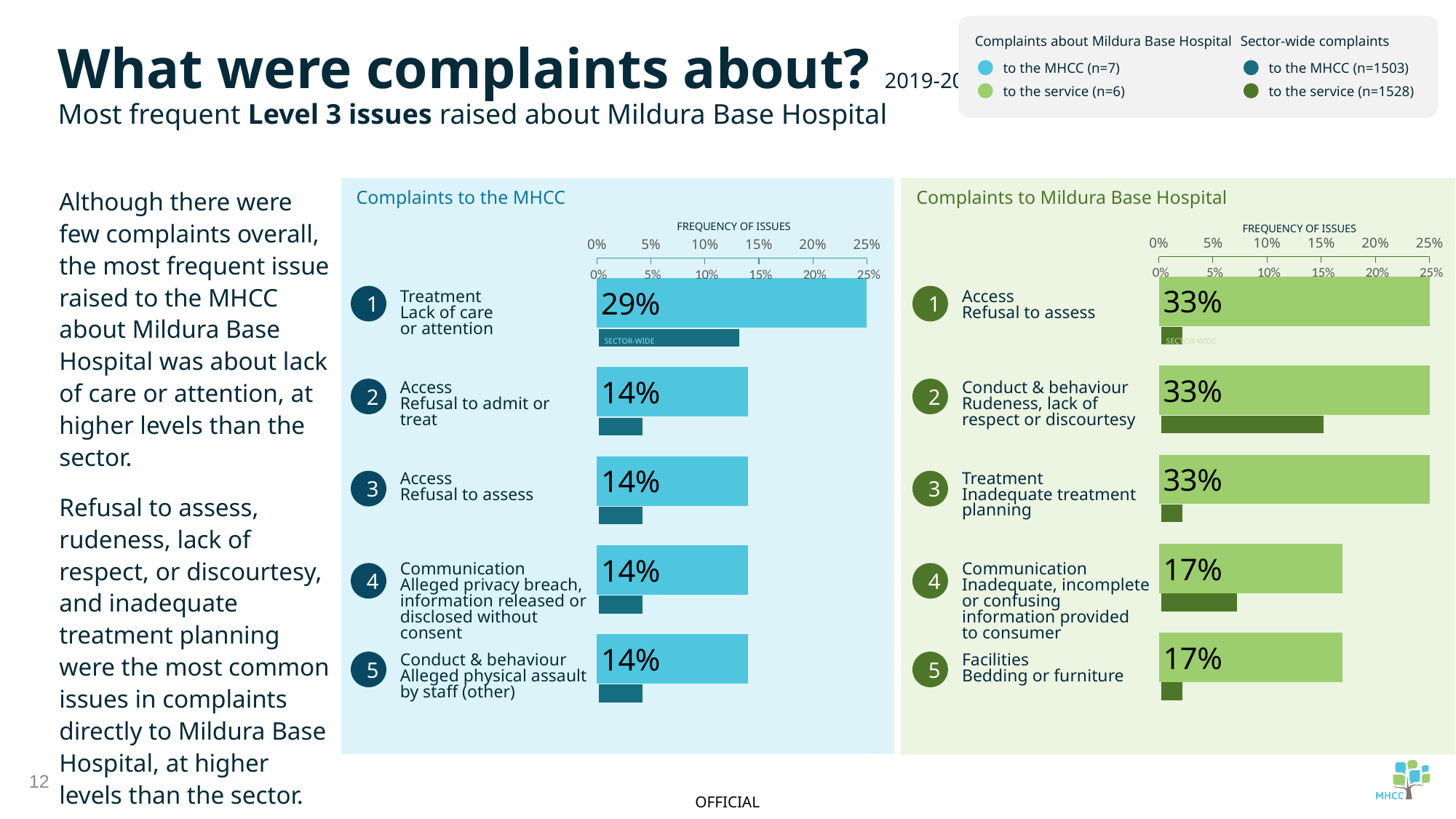
In the 'Complaints to Mildura Base Hospital' chart, is the sector-wide value for Access – Refusal to assess greater or less than 5%? less In the 'Complaints to Mildura Base Hospital' chart, what is the difference between the frequency for Access – Refusal to assess and Communication – Inadequate, incomplete or confusing information provided to consumer? 16% In the 'Complaints to the MHCC' chart, what is the frequency of issues for Treatment – Lack of care or attention? 29% In the 'Complaints to Mildura Base Hospital' chart, what is the frequency of issues for Conduct & behaviour – Rudeness, lack of respect or discourtesy? 33% In the 'Complaints to the MHCC' chart, what is the difference between the frequency for Treatment – Lack of care or attention and Access – Refusal to assess? 15% In the 'Complaints to the MHCC' chart, which issue has the highest frequency? Treatment – Lack of care or attention In the 'Complaints to the MHCC' chart, is the sector-wide value for Treatment – Lack of care or attention greater or less than 10%? greater What kind of chart is the 'Complaints to the MHCC' chart? Bar chart Which is larger: the frequency for Access – Refusal to assess in the 'Complaints to the MHCC' chart or in the 'Complaints to Mildura Base Hospital' chart? Complaints to Mildura Base Hospital In the 'Complaints to Mildura Base Hospital' chart, what is the frequency of issues for Facilities – Bedding or furniture? 17% According to the legend, how many complaints to the MHCC about Mildura Base Hospital were there (n)? n=7 How many issues are listed in the 'Complaints to Mildura Base Hospital' chart? 5